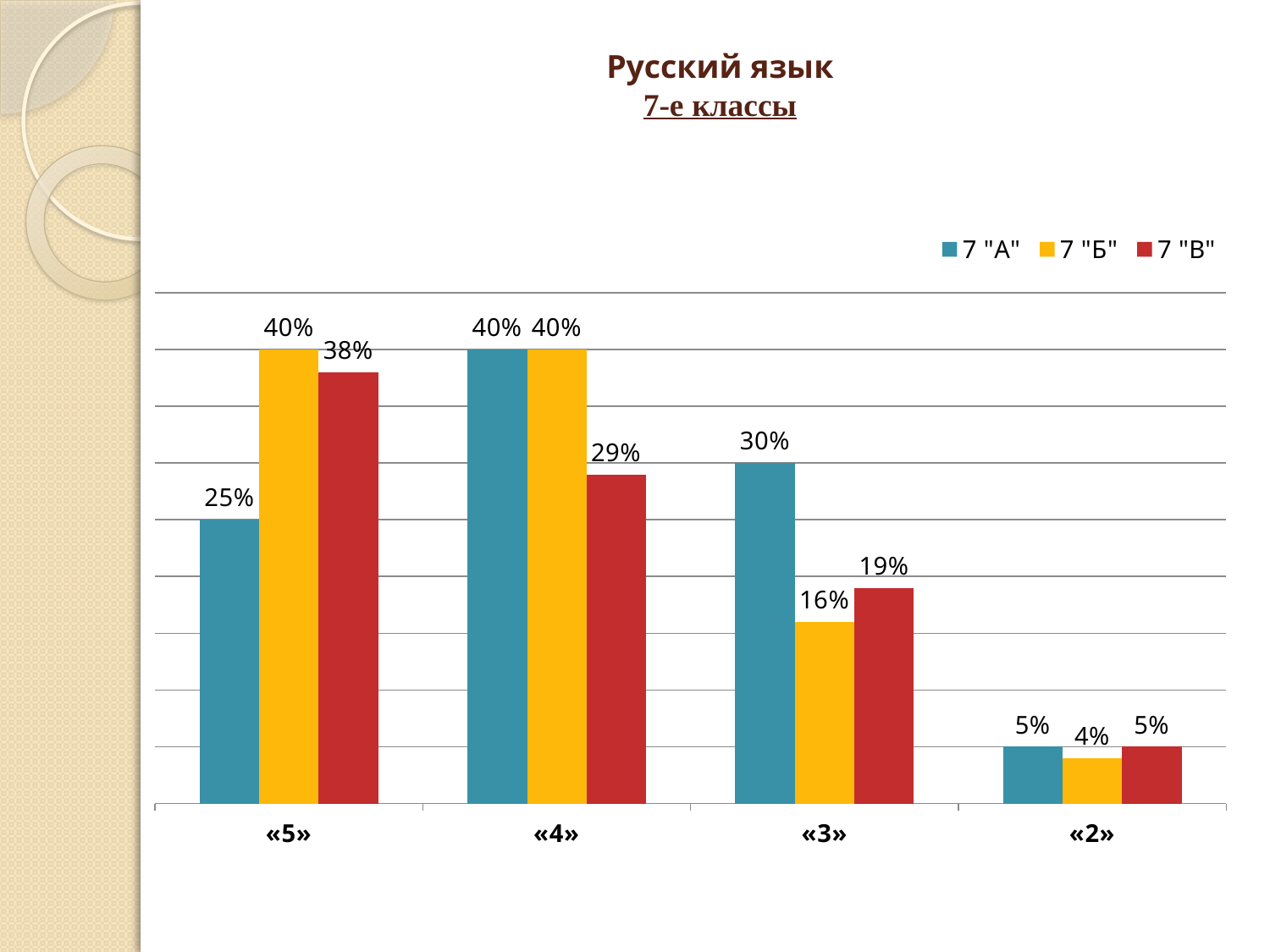
Which class has the highest value in the «3» category? 7 "А" Which class has the lowest value in the «5» category? 7 "А" What is the value for 7 "В" in the «4» category? 29% How many categories are shown on the x axis? 4 What is the difference between 7 "Б" and 7 "А" in the «5» category? 15% Which is larger: 7 "В" in the «3» category or 7 "Б" in the «3» category? 7 "В" How many series does the legend list? 3 What is the value for 7 "Б" in the «2» category? 4% What kind of chart is shown on the slide? bar chart What is the title of the slide? Русский язык 7-е классы What is the value for 7 "А" in the «5» category? 25% What is the value for 7 "Б" in the «3» category? 16%